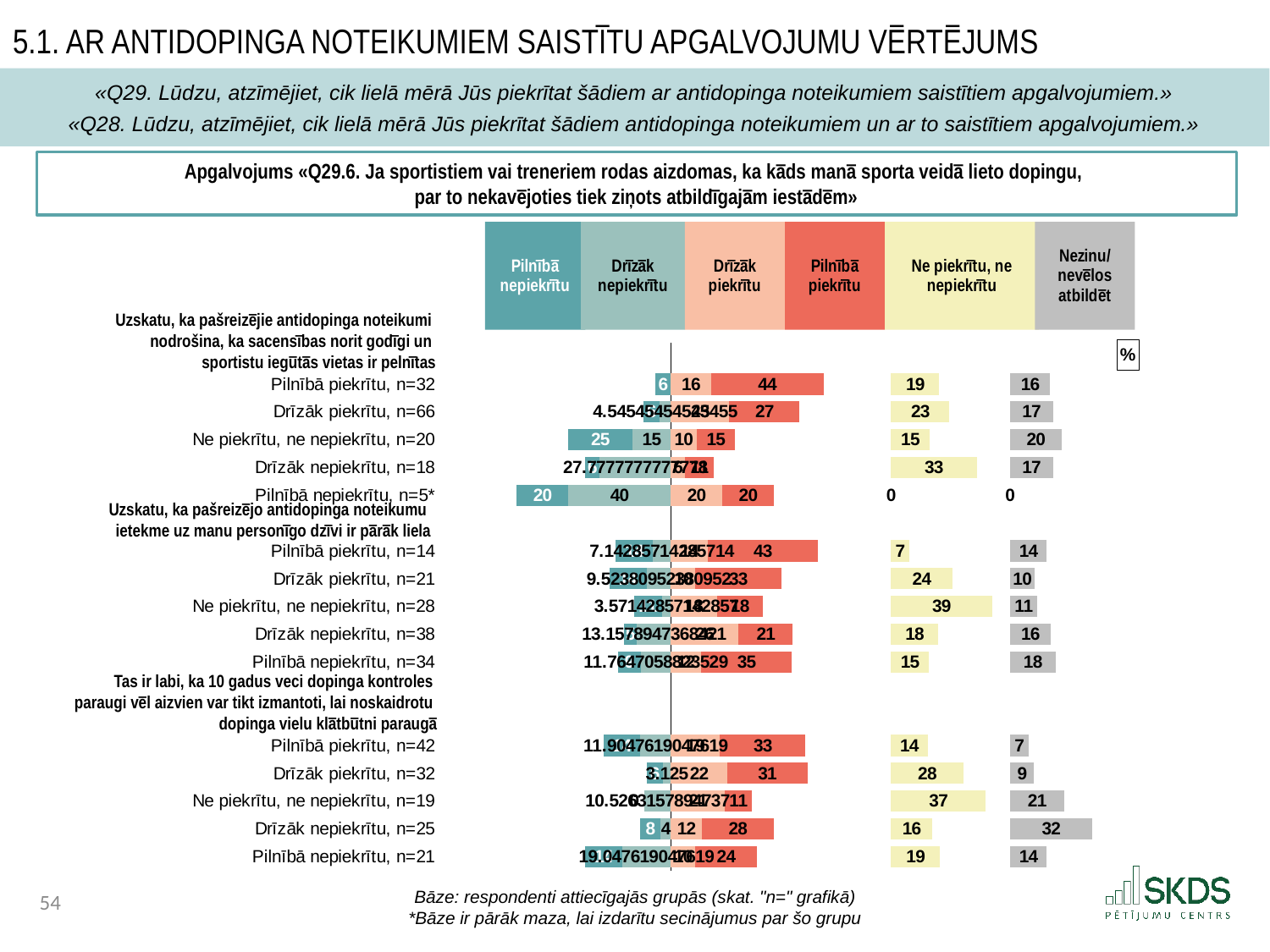
In the third group, which row has the highest 'Nezinu/nevēlos atbildēt' value? Drīzāk nepiekrītu, n=25 What is the 'Pilnībā piekrītu' value for the row 'Pilnībā piekrītu, n=32' in the first group? 44 What kind of chart is shown on the slide? bar chart What is the difference between the 'Ne piekrītu, ne nepiekrītu' values for 'Ne piekrītu, ne nepiekrītu, n=28' and 'Pilnībā piekrītu, n=14' in the second group? 32 Which is larger: the 'Pilnībā piekrītu' value for 'Pilnībā piekrītu, n=32' or for 'Drīzāk piekrītu, n=66' in the first group? Pilnībā piekrītu, n=32 How many series does the legend list? 6 What is the 'Nezinu/nevēlos atbildēt' value for the row 'Drīzāk nepiekrītu, n=25' in the third group? 32 What is the 'Pilnībā nepiekrītu' value for the row 'Ne piekrītu, ne nepiekrītu, n=20' in the first group? 25 What is the 'Drīzāk nepiekrītu' value for the row 'Pilnībā nepiekrītu, n=5*' in the first group? 40 What is the 'Ne piekrītu, ne nepiekrītu' value for the row 'Pilnībā nepiekrītu, n=5*' in the first group? 0 What is the 'Ne piekrītu, ne nepiekrītu' value for the row 'Ne piekrītu, ne nepiekrītu, n=28' in the second group? 39 In the third group, which row has the lowest 'Nezinu/nevēlos atbildēt' value? Pilnībā piekrītu, n=42